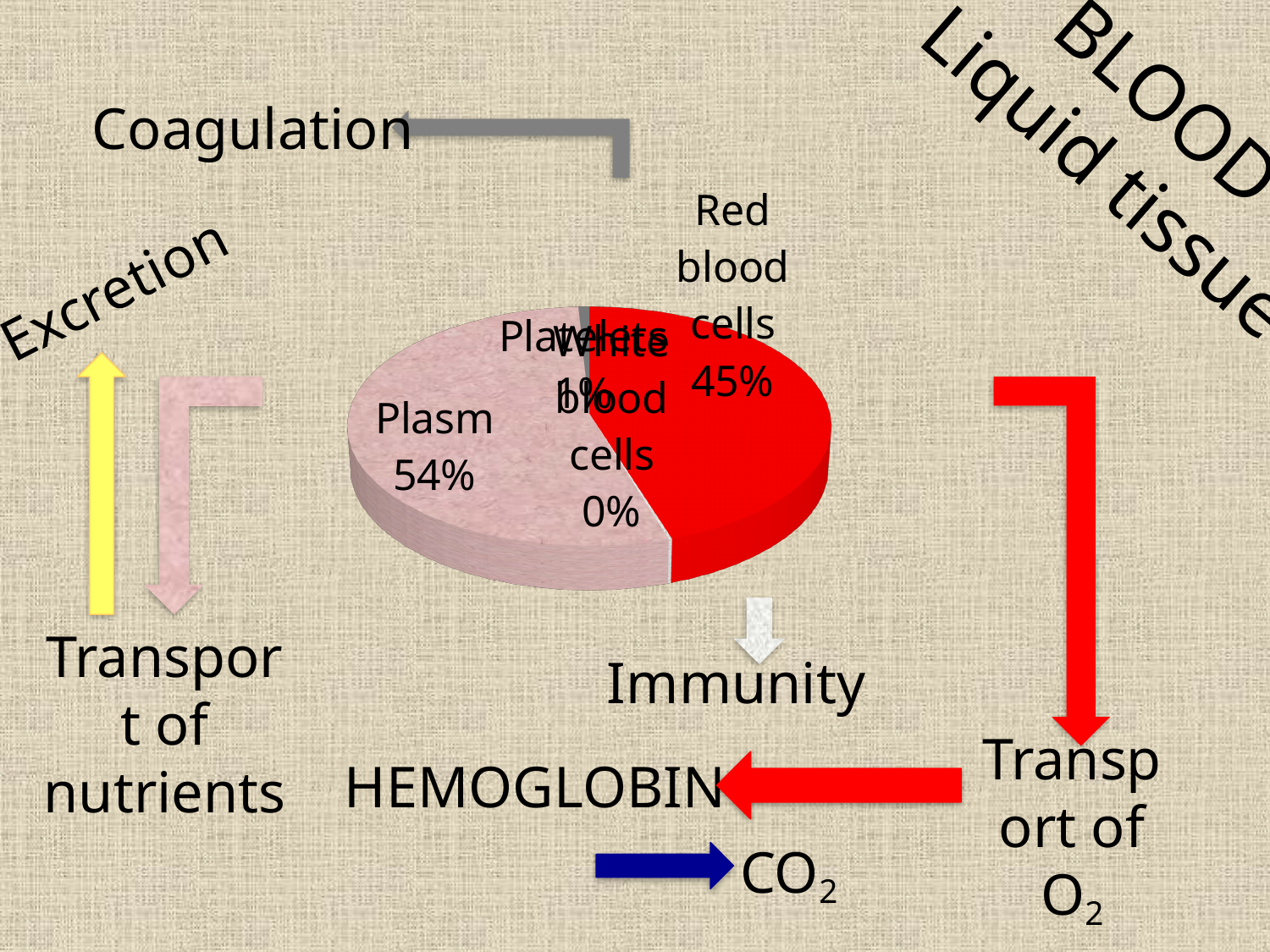
What kind of chart is shown on the slide? pie chart What percentage of the pie chart is Red blood cells? 45% What percentage of the pie chart is White blood cells? 0% What is the difference between the Plasm share and the Red blood cells share in the pie chart? 9% What percentage of the pie chart is Platelets? 1% Which slice of the pie chart is the largest? Plasm What colour is the Plasm slice of the pie chart? pink What percentage of the pie chart is Plasm? 54% Which slice of the pie chart is the smallest? White blood cells Which is larger in the pie chart, Plasm or Red blood cells? Plasm How many slices does the pie chart have? 4 What colour is the Red blood cells slice of the pie chart? red